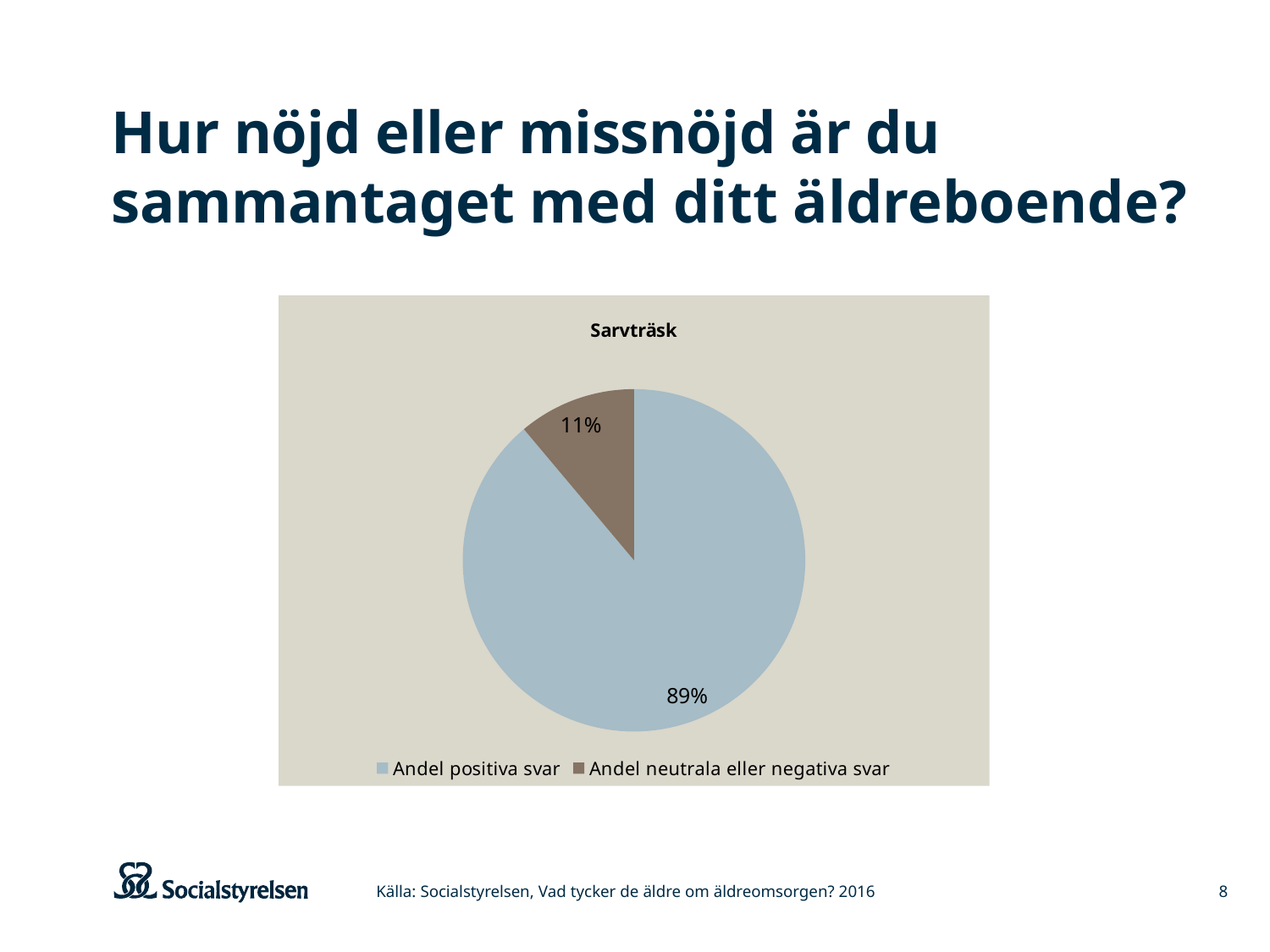
What share of the pie is 'Andel positiva svar'? 89% Which is larger, 'Andel positiva svar' or 'Andel neutrala eller negativa svar'? Andel positiva svar What is the difference in percentage points between 'Andel positiva svar' and 'Andel neutrala eller negativa svar'? 78 percentage points How many slices does the pie chart have? 2 What is the total of the two slices shown? 100% Which slice is the smallest? Andel neutrala eller negativa svar What type of chart is shown on the slide? pie chart What colour is the 'Andel neutrala eller negativa svar' slice? brown How many entries does the legend list? 2 What share of the pie is 'Andel neutrala eller negativa svar'? 11% What is the title of the chart? Sarvträsk Which slice is the largest? Andel positiva svar